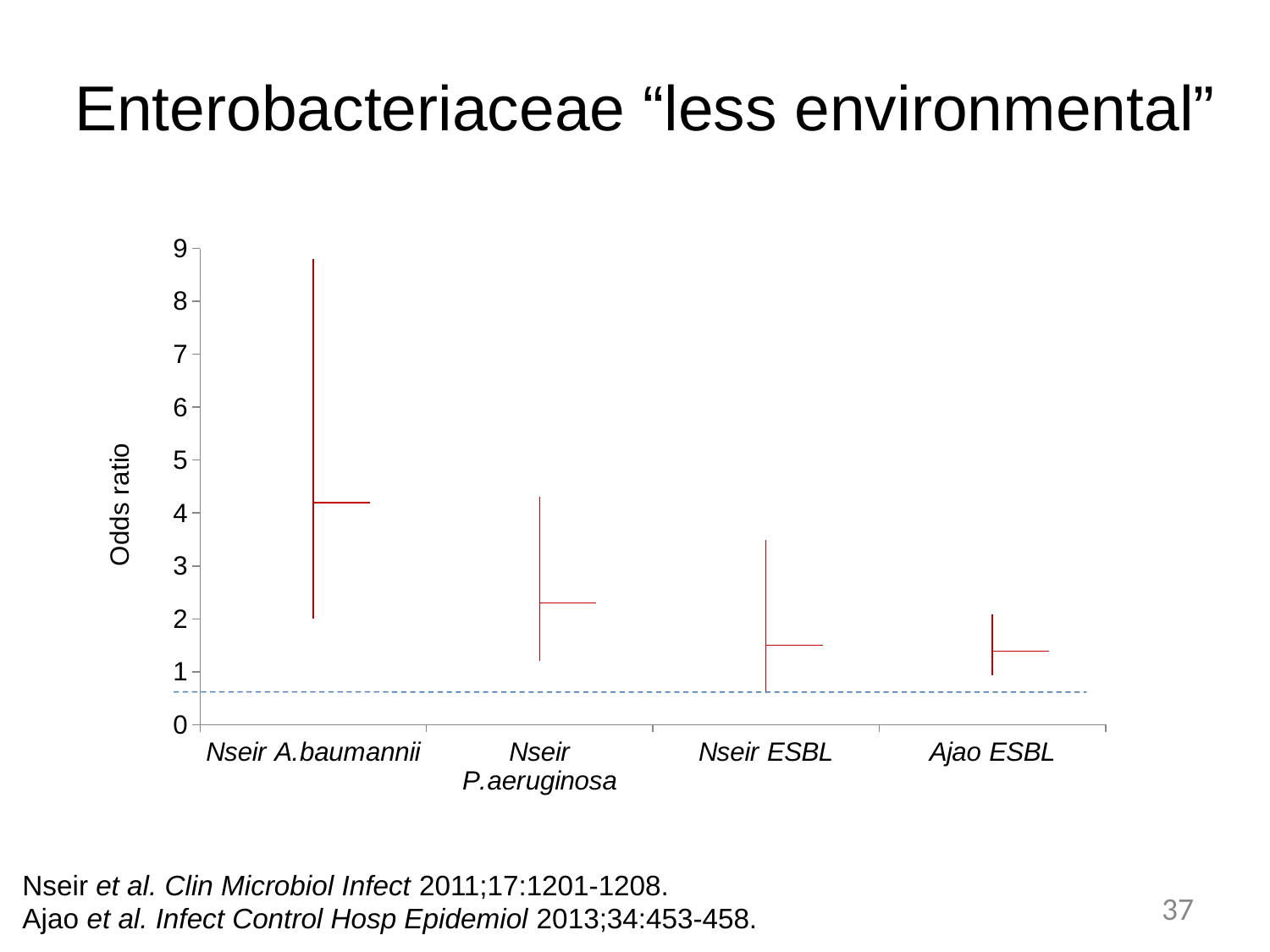
Is the upper end of the interval for Nseir A.baumannii greater or less than 8? greater How many categories are shown on the x axis of the chart? 4 What is the title of the slide containing the chart? Enterobacteriaceae "less environmental" Do the odds ratio point estimates rise or fall from left to right across the x axis? fall Which has the larger odds ratio point estimate, Nseir A.baumannii or Nseir P.aeruginosa? Nseir A.baumannii What is the label of the y axis? Odds ratio Is the odds ratio point estimate for Nseir A.baumannii greater or less than 3? greater Is the odds ratio point estimate for Nseir ESBL greater or less than 2? less Which category has the highest odds ratio point estimate? Nseir A.baumannii Which has the larger odds ratio point estimate, Nseir P.aeruginosa or Ajao ESBL? Nseir P.aeruginosa